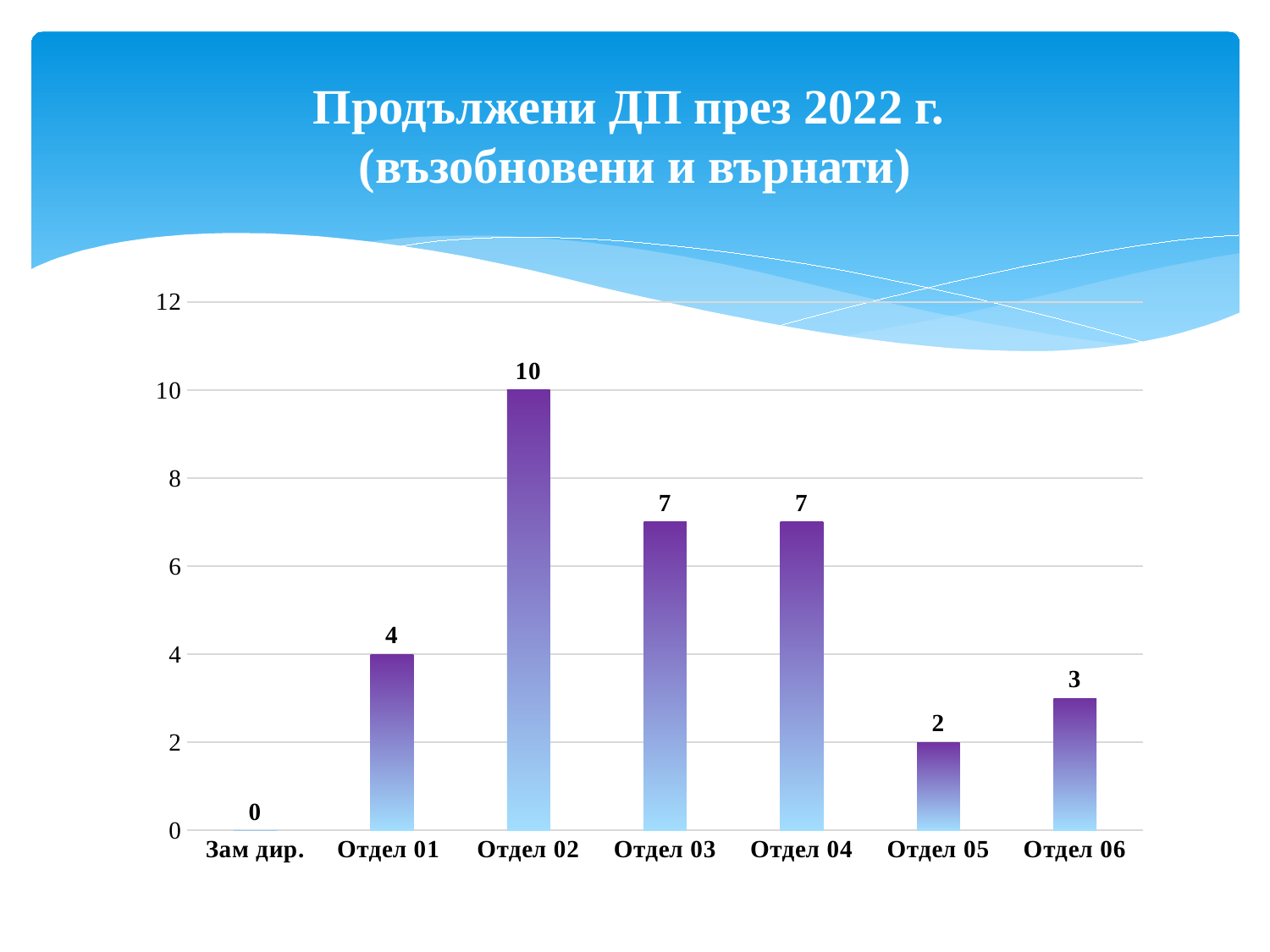
Is the value for Отдел 03 greater or less than 6? greater Which category has the lowest value? Зам дир. How many categories are shown on the x axis? 7 What is the value for Отдел 02? 10 What is the difference between the values for Отдел 02 and Отдел 01? 6 What is the difference between the values for Отдел 04 and Отдел 06? 4 What is the title of the slide? Продължени ДП през 2022 г. (възобновени и върнати) Which is larger, the value for Отдел 06 or the value for Отдел 05? Отдел 06 What is the value for Зам дир.? 0 Which category has the highest value? Отдел 02 What is the value for Отдел 05? 2 What kind of chart is shown on the slide? bar chart